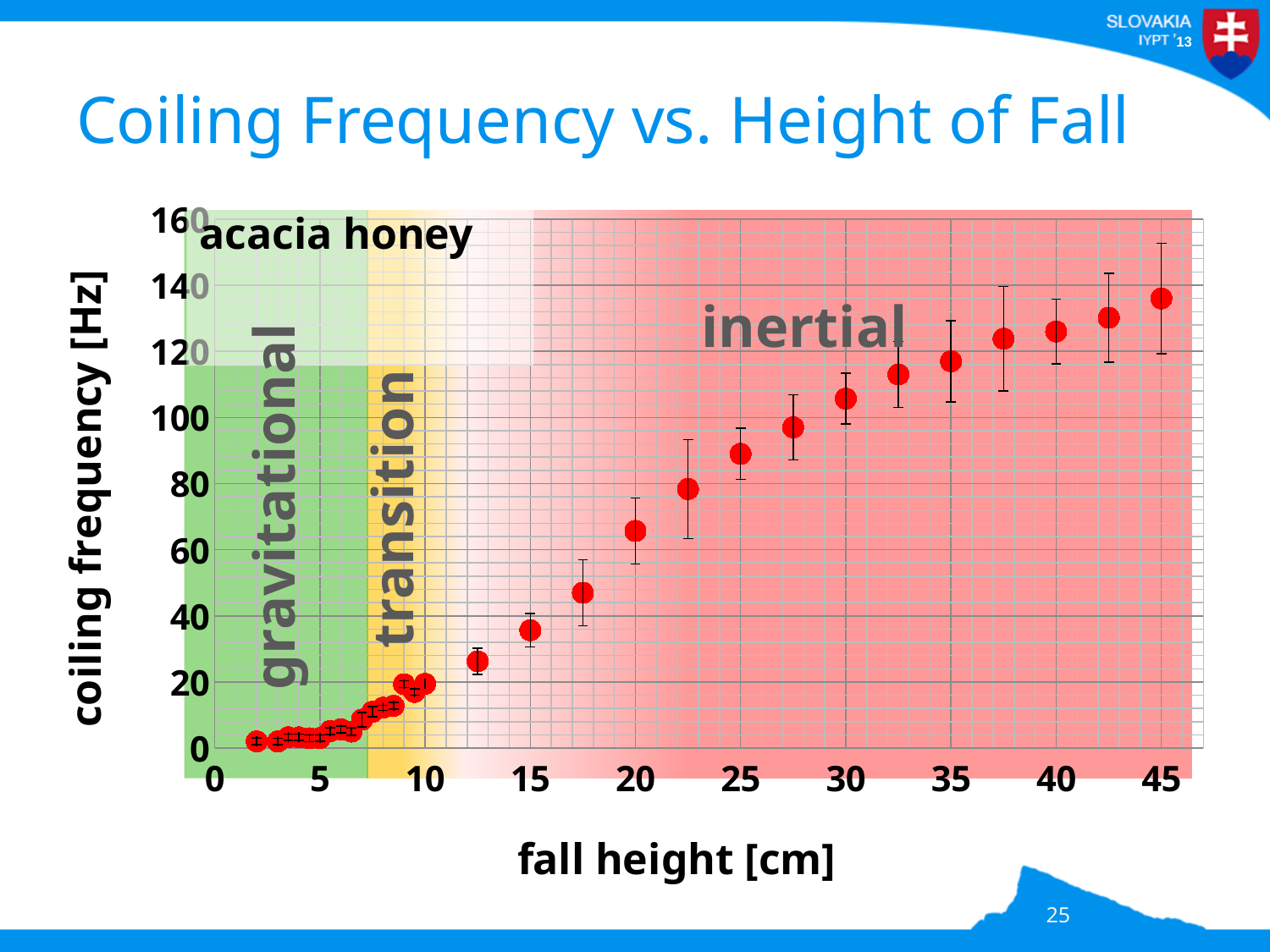
Is the coiling frequency at a fall height of 45 cm greater or less than 120 Hz? greater Which liquid is the chart's data for, according to the label in the plot area? acacia honey Which has the lower coiling frequency: a fall height of 5 cm or 40 cm? 5 cm Which has the higher coiling frequency: a fall height of 15 cm or 35 cm? 35 cm What kind of chart is shown on the slide? scatter plot Is the coiling frequency at a fall height of 30 cm greater or less than 100 Hz? greater Is the coiling frequency at a fall height of 20 cm greater or less than 80 Hz? less At which fall height is the coiling frequency highest? 45 cm Does the coiling frequency rise or fall as the fall height increases? rises What are the three regimes labelled on the chart from left to right? gravitational, transition, inertial